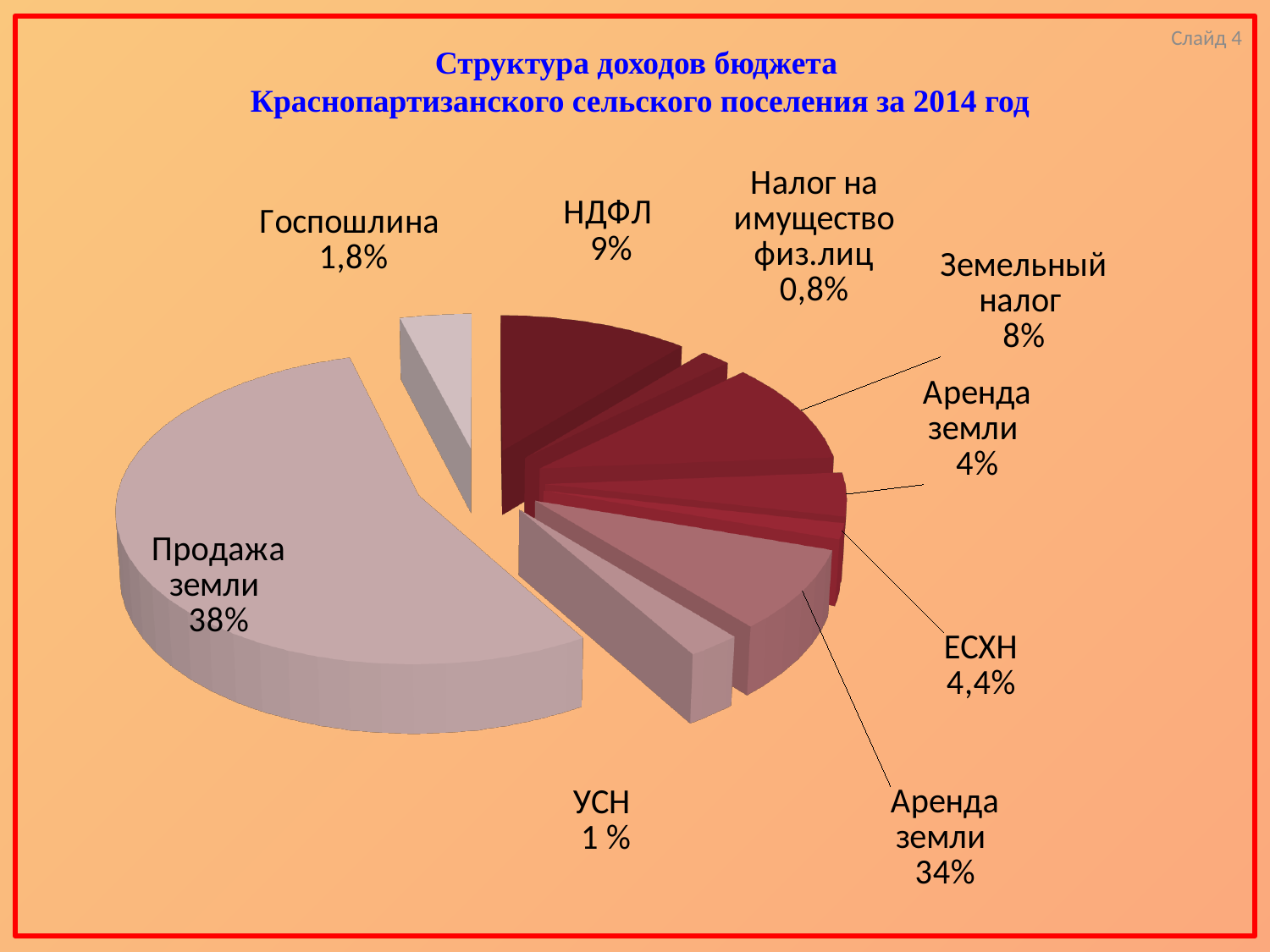
Which is larger, the share for НДФЛ or the share for Земельный налог? НДФЛ What is the difference in percentage points between Продажа земли (38%) and the larger Аренда земли slice (34%)? 4% What is the title of the chart? Структура доходов бюджета Краснопартизанского сельского поселения за 2014 год Which category has the smallest share of the pie? Налог на имущество физ.лиц What share of the budget revenue is Продажа земли? 38% What share is shown for ЕСХН? 4,4% What kind of chart is shown on the slide? pie chart What share is shown for Госпошлина? 1,8% What share is shown for НДФЛ? 9% What share is shown for Налог на имущество физ.лиц? 0,8% Which category has the largest share of the pie? Продажа земли How many slices does the pie chart have? 9